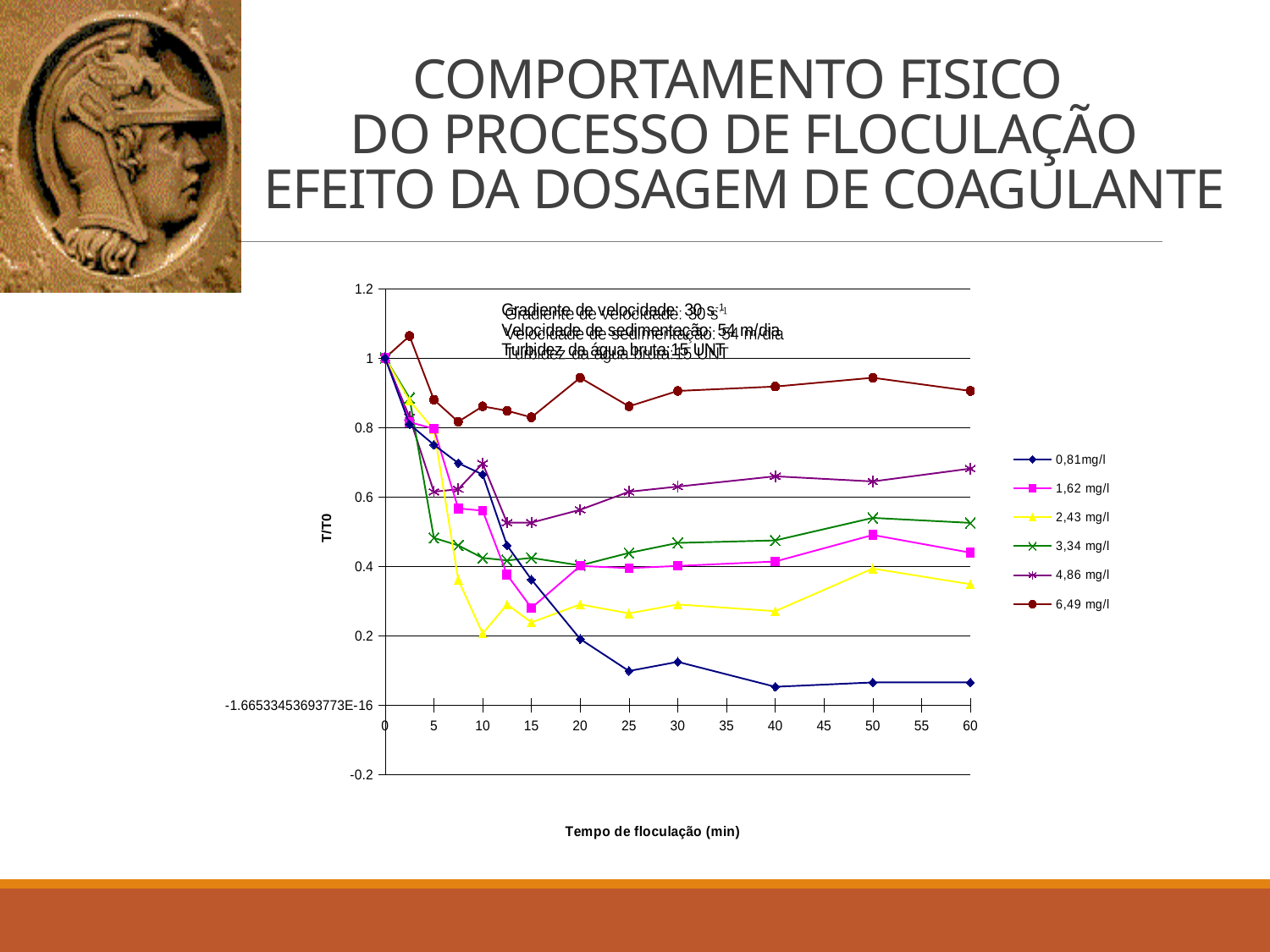
At 60 min, which series has the larger value: 1,62 mg/l or 2,43 mg/l? 1,62 mg/l Which series has the highest T/T0 value at 60 min? 6,49 mg/l Is the value for the 6,49 mg/l series at 60 min greater or less than 0.8? greater Is the value for the 4,86 mg/l series at 60 min greater or less than 0.6? greater How many series does the legend list? 6 Which series has the lowest T/T0 value at 60 min? 0,81mg/l Is the value for the 0,81mg/l series at 40 min greater or less than 0.2? less What is the T/T0 value of the 0,81mg/l series at 0 min? 1 What is the title of the y axis of the chart? T/T0 What is the title of the x axis of the chart? Tempo de floculação (min) What kind of chart is shown on the slide? line chart